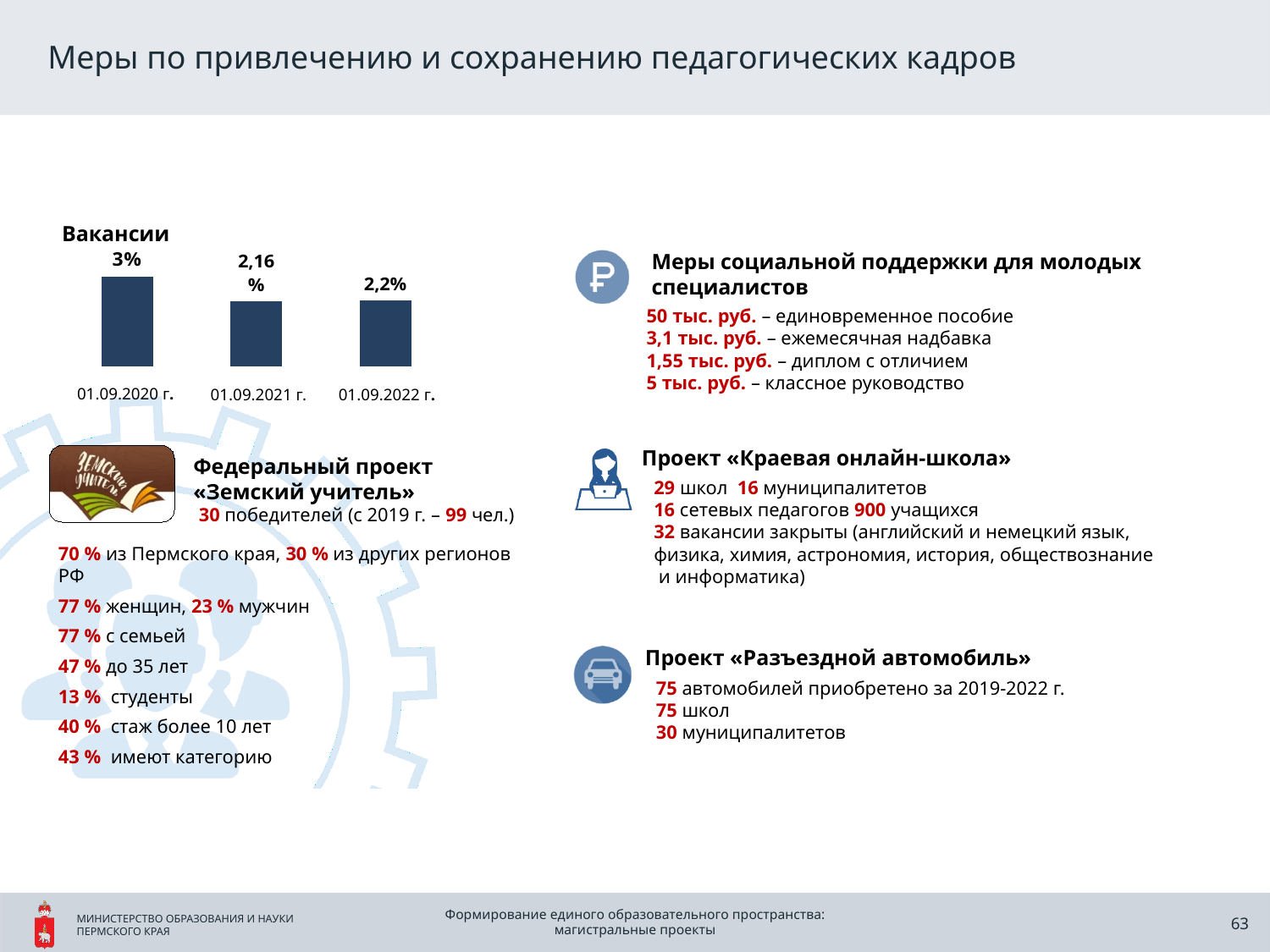
Did the vacancy rate rise or fall from 01.09.2020 г. to 01.09.2021 г. in the Вакансии chart? Fall What is the difference between the vacancy rates for 01.09.2020 г. and 01.09.2021 г. in the Вакансии chart? 0,84% By how many percentage points did the vacancy rate fall from 01.09.2020 г. to 01.09.2022 г. in the Вакансии chart? 0,8% What type of chart is the Вакансии chart? Bar chart What is the title of the bar chart on the slide? Вакансии Which date has the lowest vacancy rate in the Вакансии chart? 01.09.2021 г. Which is larger in the Вакансии chart: the value for 01.09.2021 г. or for 01.09.2022 г.? 01.09.2022 г. What is the vacancy rate shown for 01.09.2020 г. in the Вакансии chart? 3% What is the vacancy rate shown for 01.09.2022 г. in the Вакансии chart? 2,2% Which date has the highest vacancy rate in the Вакансии chart? 01.09.2020 г. What is the vacancy rate shown for 01.09.2021 г. in the Вакансии chart? 2,16% How many dates (bars) are shown in the Вакансии chart? 3